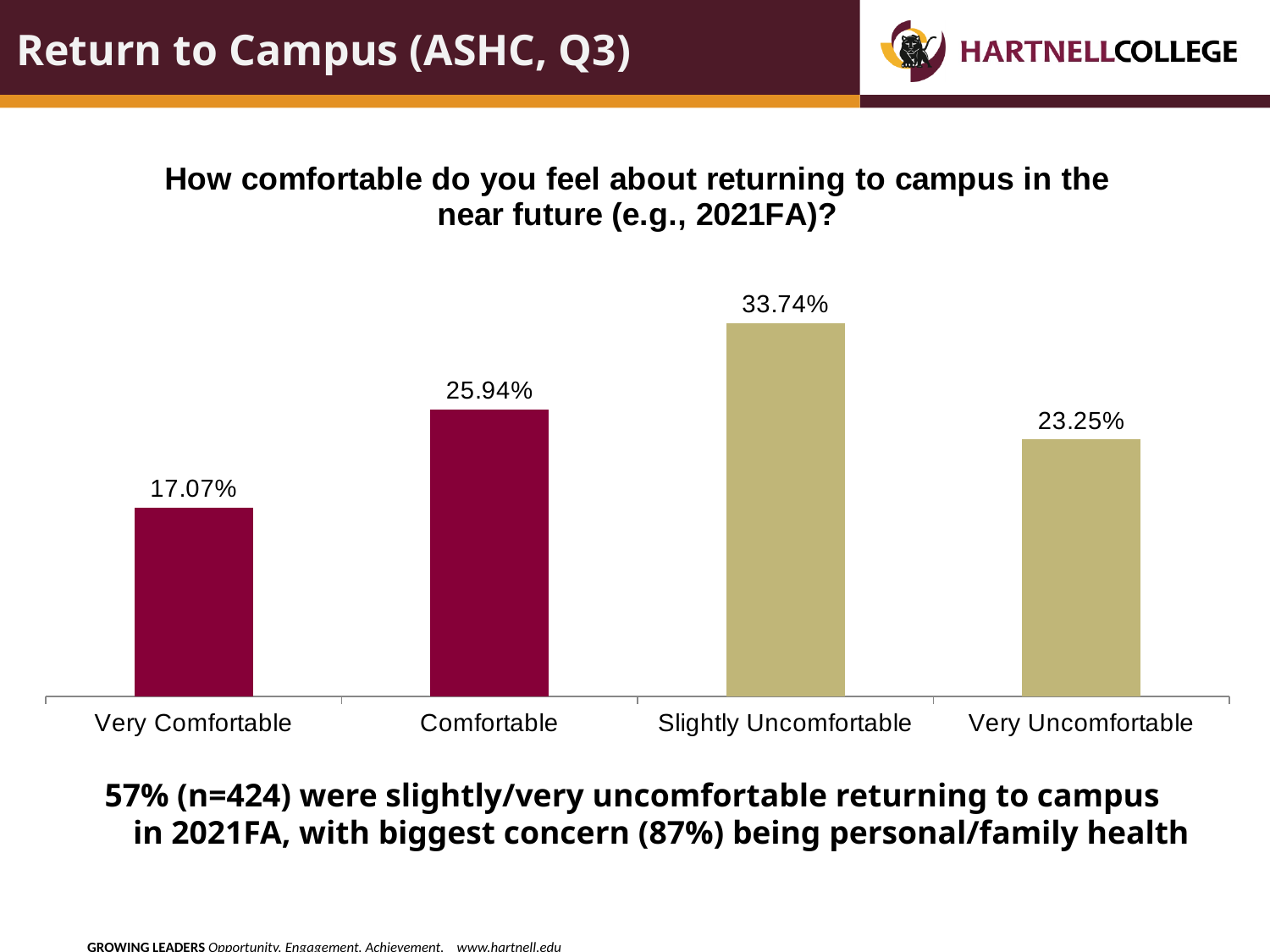
What is the combined percentage for Very Comfortable and Comfortable? 43.01% Which is larger, the percentage for Comfortable or for Very Uncomfortable? Comfortable What percentage of respondents said they were Very Uncomfortable returning to campus? 23.25% Which response category has the highest percentage? Slightly Uncomfortable What percentage of respondents said they were Slightly Uncomfortable returning to campus? 33.74% What is the difference in percentage points between Slightly Uncomfortable and Very Comfortable? 16.67 What type of chart is shown on the slide? Bar chart How many response categories are shown on the chart? 4 What is the difference in percentage points between Comfortable and Very Uncomfortable? 2.69 Which response category has the lowest percentage? Very Comfortable What percentage of respondents said they were Comfortable returning to campus? 25.94% What percentage of respondents said they were Very Comfortable returning to campus? 17.07%